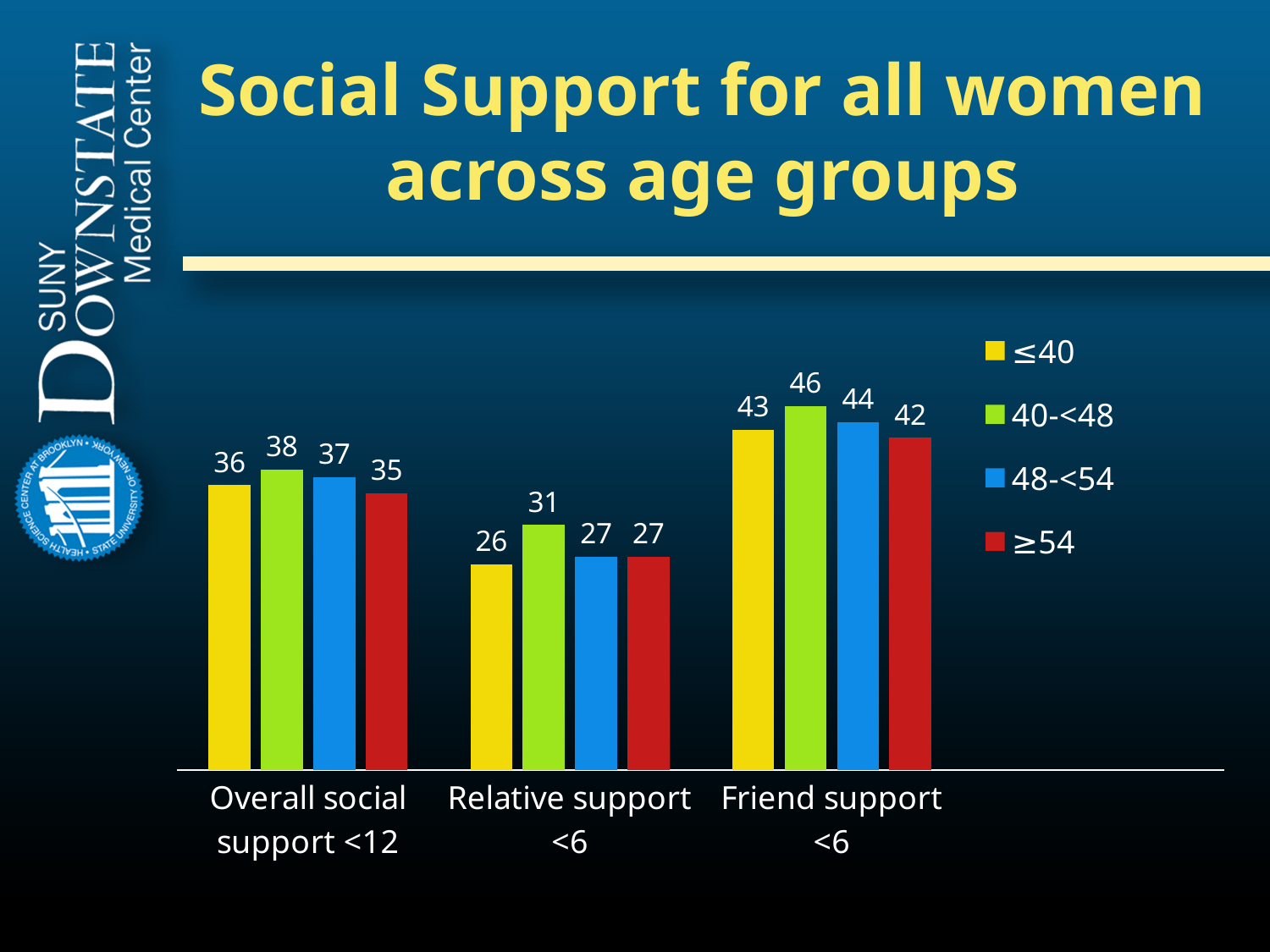
How many series does the legend list? 4 What is the value for the ≥54 age group in the Friend support <6 category? 42 What kind of chart is shown on the slide? Bar chart Which age group has the lowest value in the Relative support <6 category? ≤40 Which is larger: the 48-<54 value for Overall social support <12 or the 48-<54 value for Friend support <6? Friend support <6 How many categories are shown on the x axis? 3 What is the difference between the 40-<48 and ≤40 values in the Relative support <6 category? 5 Which age group has the highest value in the Friend support <6 category? 40-<48 What is the value for the ≤40 age group in the Relative support <6 category? 26 What is the title of the slide? Social Support for all women across age groups What is the value for the 40-<48 age group in the Overall social support <12 category? 38 Which colour represents the ≥54 age group in the legend? Red